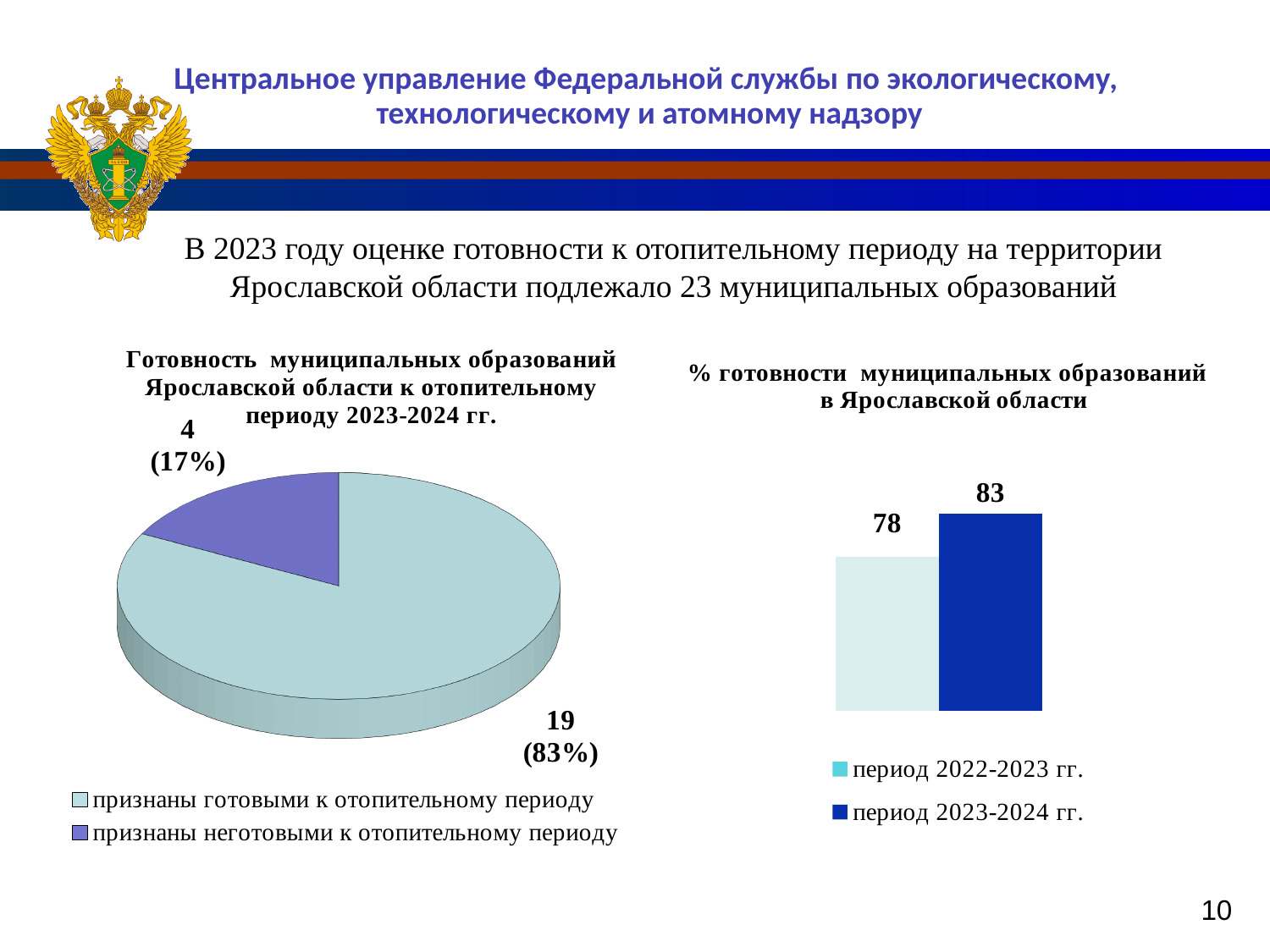
In the pie chart on the left, which category is the largest? признаны готовыми к отопительному периоду In the pie chart on the left, what share of the pie is the slice for municipalities recognised as ready for the heating period? 83% In the pie chart on the left, what is the difference between the number of municipalities recognised as ready and those recognised as not ready? 15 In the bar chart on the right (% готовности муниципальных образований в Ярославской области), what is the value for период 2023-2024 гг.? 83 In the pie chart on the left, how many municipalities were recognised as not ready for the heating period (признаны неготовыми к отопительному периоду)? 4 In the bar chart on the right, what is the difference between the values for период 2023-2024 гг. and период 2022-2023 гг.? 5 What kind of chart is the chart on the left of the slide? Pie chart In the pie chart on the left, what share of the pie is the slice for municipalities recognised as not ready for the heating period? 17% In the pie chart on the left, how many municipalities were recognised as ready for the heating period (признаны готовыми к отопительному периоду)? 19 How many series does the legend of the bar chart on the right list? 2 In the bar chart on the right (% готовности муниципальных образований в Ярославской области), what is the value for период 2022-2023 гг.? 78 In the bar chart on the right, which period has the higher value: период 2022-2023 гг. or период 2023-2024 гг.? период 2023-2024 гг.